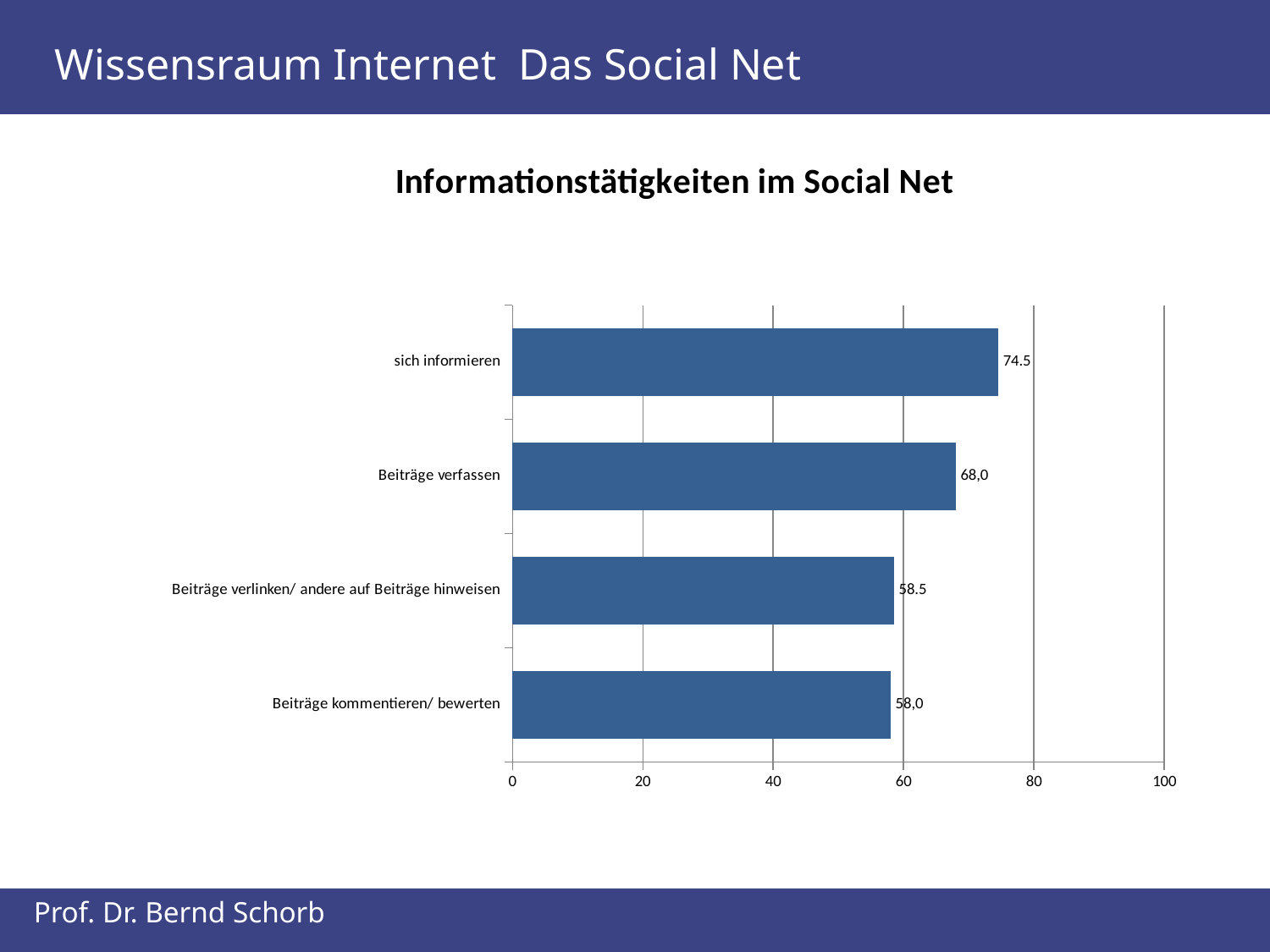
What is the value for "sich informieren"? 74.5 Which is larger, the value for "Beiträge verfassen" or the value for "Beiträge verlinken/ andere auf Beiträge hinweisen"? Beiträge verfassen What is the value for "Beiträge kommentieren/ bewerten"? 58,0 What is the value for "Beiträge verfassen"? 68,0 How many categories are shown in the chart? 4 What kind of chart is shown on the slide? bar chart Which category has the highest value? sich informieren What is the difference between the values for "sich informieren" and "Beiträge verfassen"? 6.5 Which category has the lowest value? Beiträge kommentieren/ bewerten What is the value for "Beiträge verlinken/ andere auf Beiträge hinweisen"? 58.5 What is the title of the chart? Informationstätigkeiten im Social Net Is the value for "sich informieren" greater or less than 80? less